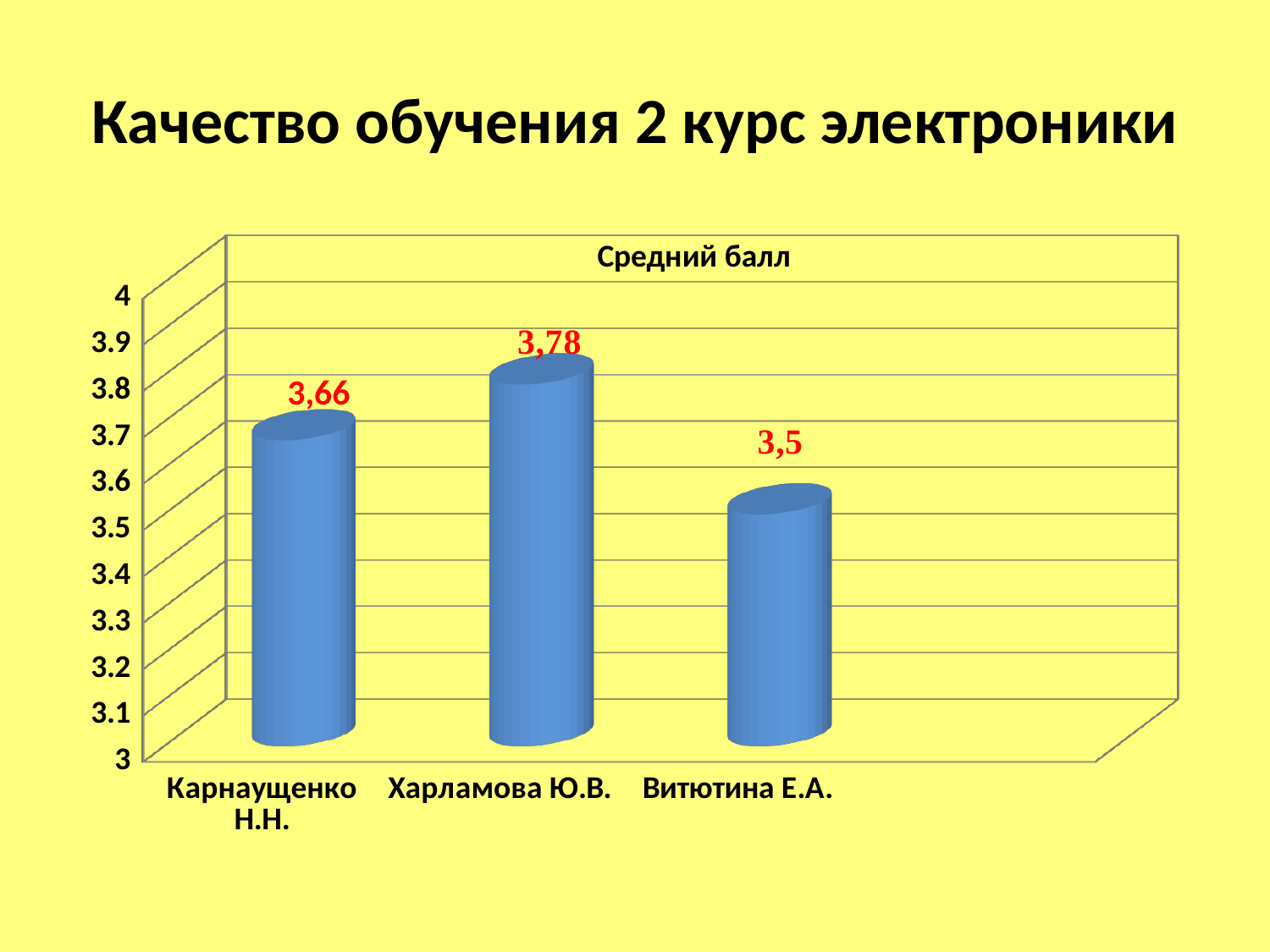
What is the difference between the average scores of Харламова Ю.В. and Витютина Е.А.? 0,28 Is the value for Витютина Е.А. greater or less than 3.6? less What is the average score for Витютина Е.А.? 3,5 Which teacher has the lowest average score? Витютина Е.А. What is the title of the chart? Средний балл Which teacher has the highest average score? Харламова Ю.В. Who has a higher average score, Карнаущенко Н.Н. or Витютина Е.А.? Карнаущенко Н.Н. How many teachers are shown on the chart? 3 What is the difference between the average scores of Харламова Ю.В. and Карнаущенко Н.Н.? 0,12 What is the average score for Харламова Ю.В.? 3,78 What is the average score (Средний балл) for Карнаущенко Н.Н.? 3,66 What kind of chart is shown on the slide? Bar chart